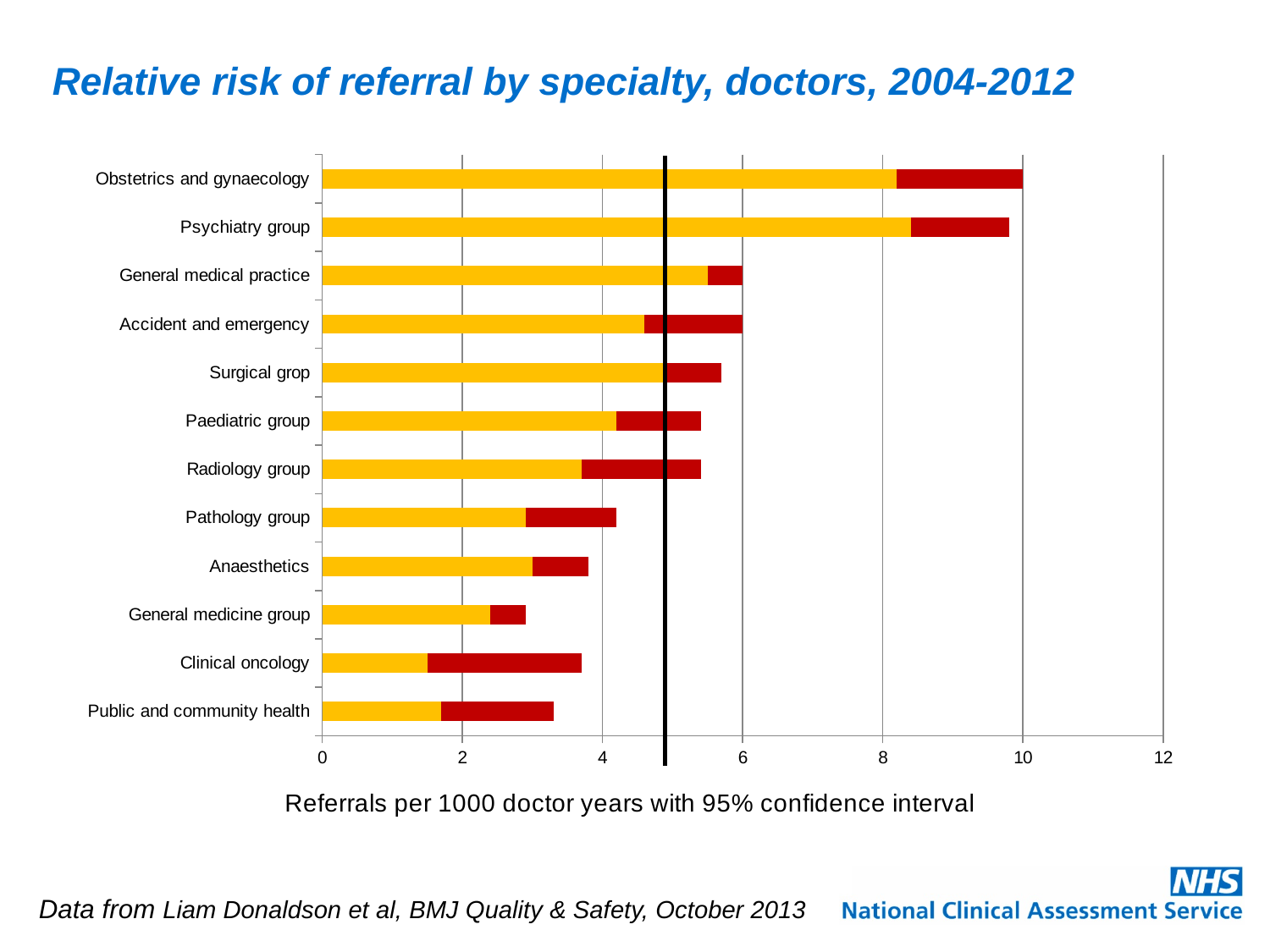
Is the total bar length for Surgical grop greater or less than 4? greater Which has the longer total bar, Psychiatry group or General medical practice? Psychiatry group Which has the longer total bar, Paediatric group or Pathology group? Paediatric group What kind of chart is shown on the slide? Bar chart Is the total bar length for Public and community health greater or less than 4? less Is the total bar length for Obstetrics and gynaecology greater or less than 8? greater How many specialties are listed on the chart? 12 What is the label on the horizontal axis of the chart? Referrals per 1000 doctor years with 95% confidence interval Which specialty is listed at the top of the chart? Obstetrics and gynaecology